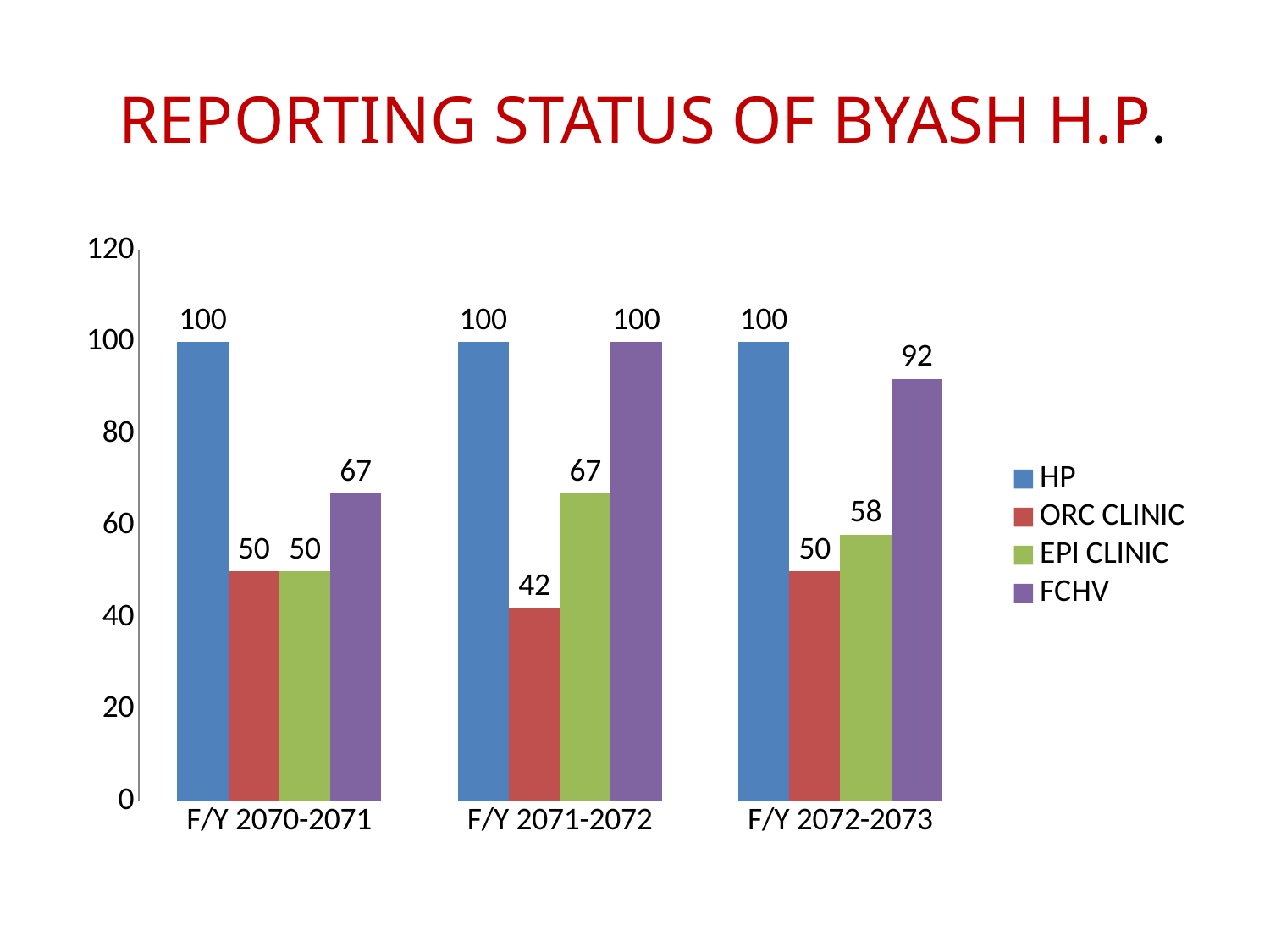
What is the value for EPI CLINIC in F/Y 2072-2073? 58 What is the difference between the EPI CLINIC and ORC CLINIC values in F/Y 2071-2072? 25 What is the value for FCHV in F/Y 2072-2073? 92 Which series has the lowest value in F/Y 2071-2072? ORC CLINIC What is the value for FCHV in F/Y 2070-2071? 67 What is the value for ORC CLINIC in F/Y 2071-2072? 42 How many series does the legend list? 4 Which is larger: EPI CLINIC in F/Y 2072-2073 or EPI CLINIC in F/Y 2071-2072? EPI CLINIC in F/Y 2071-2072 Which series has the lowest value in F/Y 2072-2073? ORC CLINIC What is the difference between the FCHV values for F/Y 2071-2072 and F/Y 2072-2073? 8 How many fiscal year categories are shown on the x axis? 3 What kind of chart is shown on the slide? Bar chart